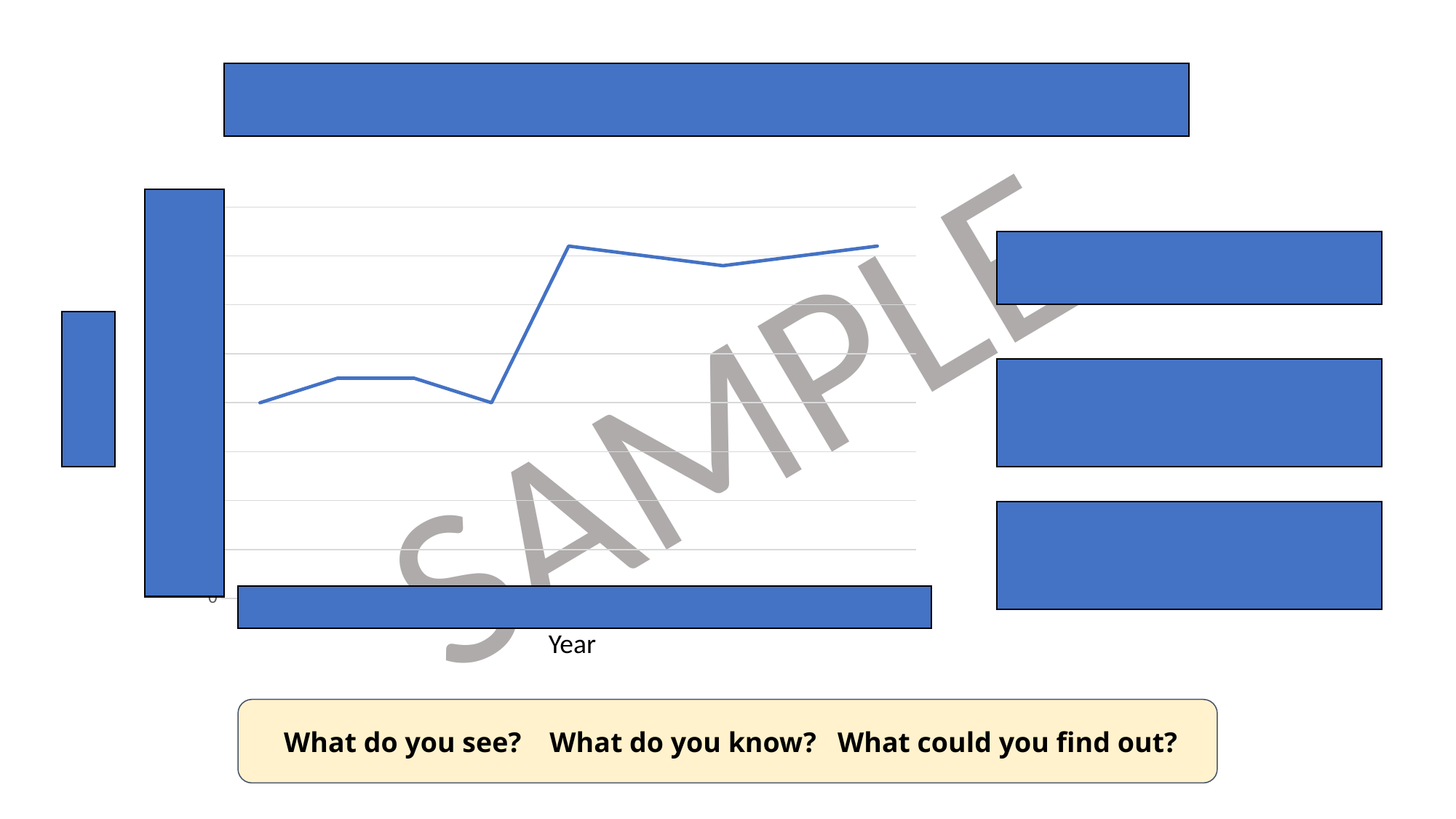
Does the line end higher or lower than where it starts on the left? higher What colour is the plotted line in the chart? blue How many lines are plotted in the chart? 1 What is the title of the x axis of the chart? Year What kind of chart is shown on the slide? line chart